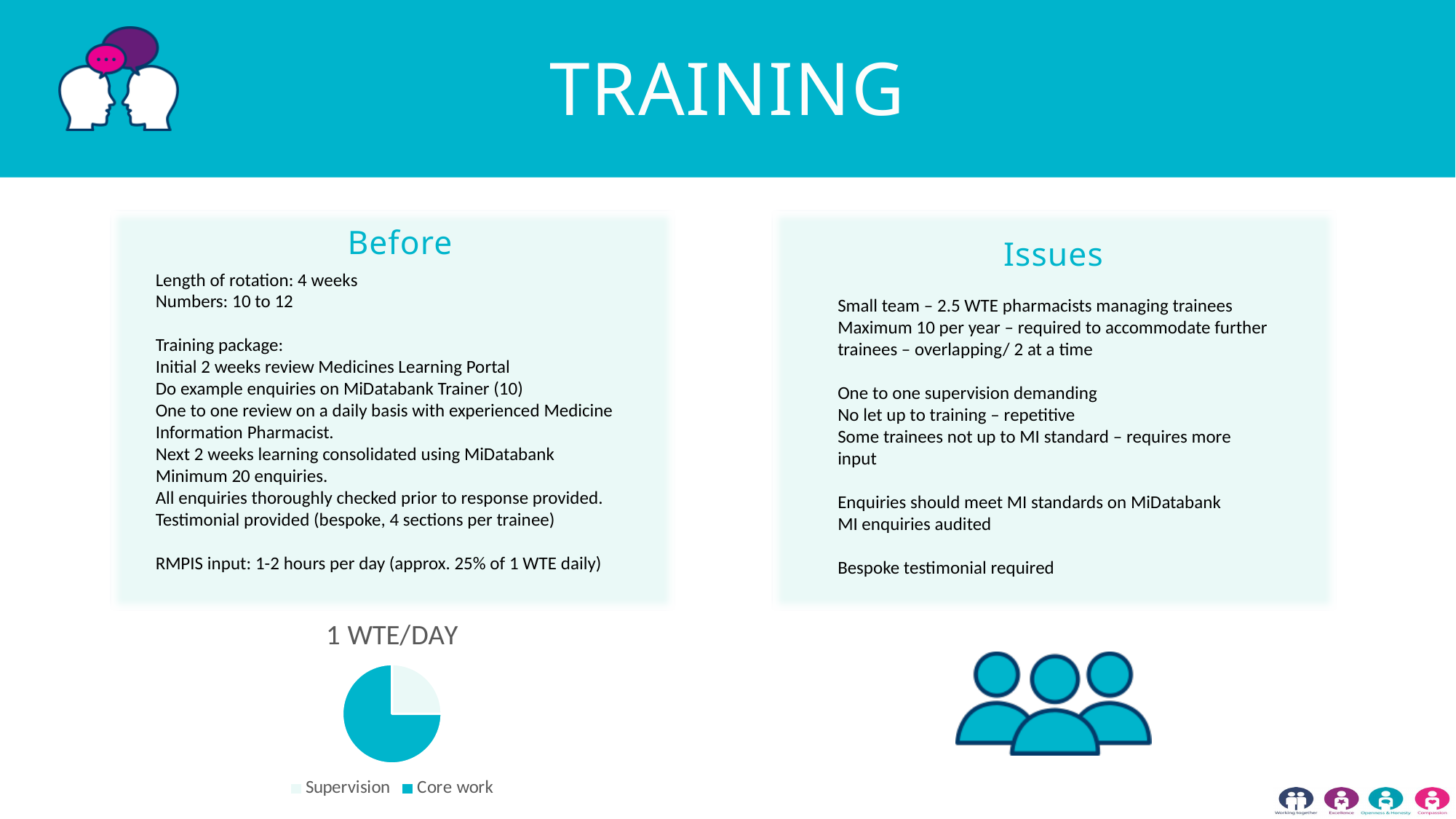
What kind of chart is shown on the slide? pie chart How many entries does the pie chart's legend list? 2 Which slice of the pie chart is the smallest? Supervision Which legend entry in the pie chart is shown in the darker teal colour? Core work Which slice of the pie chart is the largest? Core work What is the title of the pie chart? 1 WTE/DAY How many slices does the pie chart have? 2 In the pie chart, which is larger: Supervision or Core work? Core work